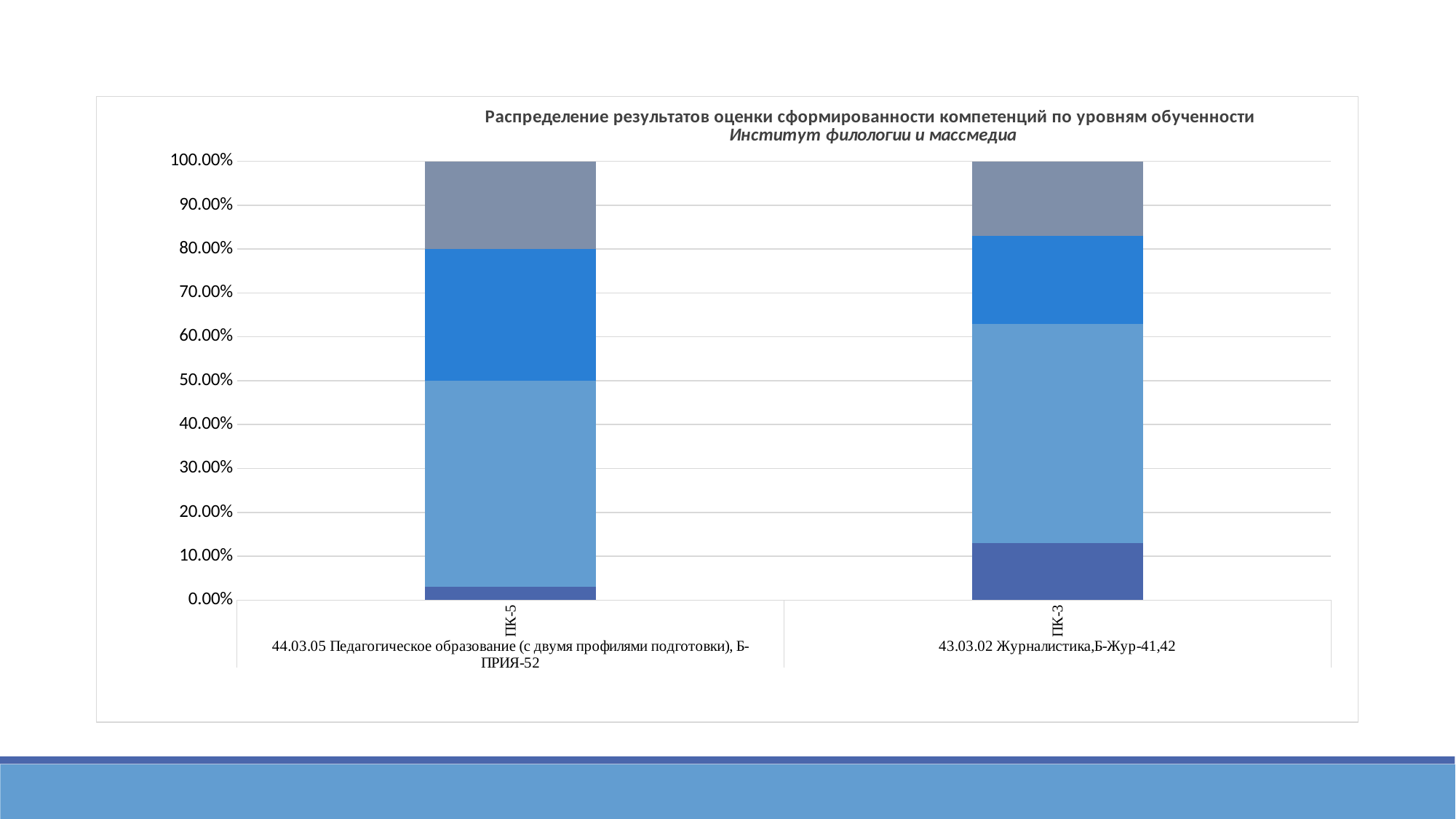
What kind of chart is shown on the slide? stacked bar chart What is the total height of the stacked bar for ПК-5? 100.00% Which bar has the larger medium blue (third from bottom) segment, ПК-5 or ПК-3? ПК-5 Is the dark blue bottom segment of the ПК-3 bar greater or less than 10.00%? greater Which competency label belongs to the programme 43.03.02 Журналистика, Б-Жур-41,42? ПК-3 What is the title of the chart? Распределение результатов оценки сформированности компетенций по уровням обученности Which bar has the larger dark blue bottom segment, ПК-5 or ПК-3? ПК-3 What is the total height of the stacked bar for ПК-3? 100.00% Is the dark blue bottom segment of the ПК-5 bar greater or less than 10.00%? less How many bars (categories) are plotted in the chart? 2 Does the top of the light blue segment in the ПК-3 bar lie above or below the 60.00% line? above Which institute is named in the chart's subtitle? Институт филологии и массмедиа